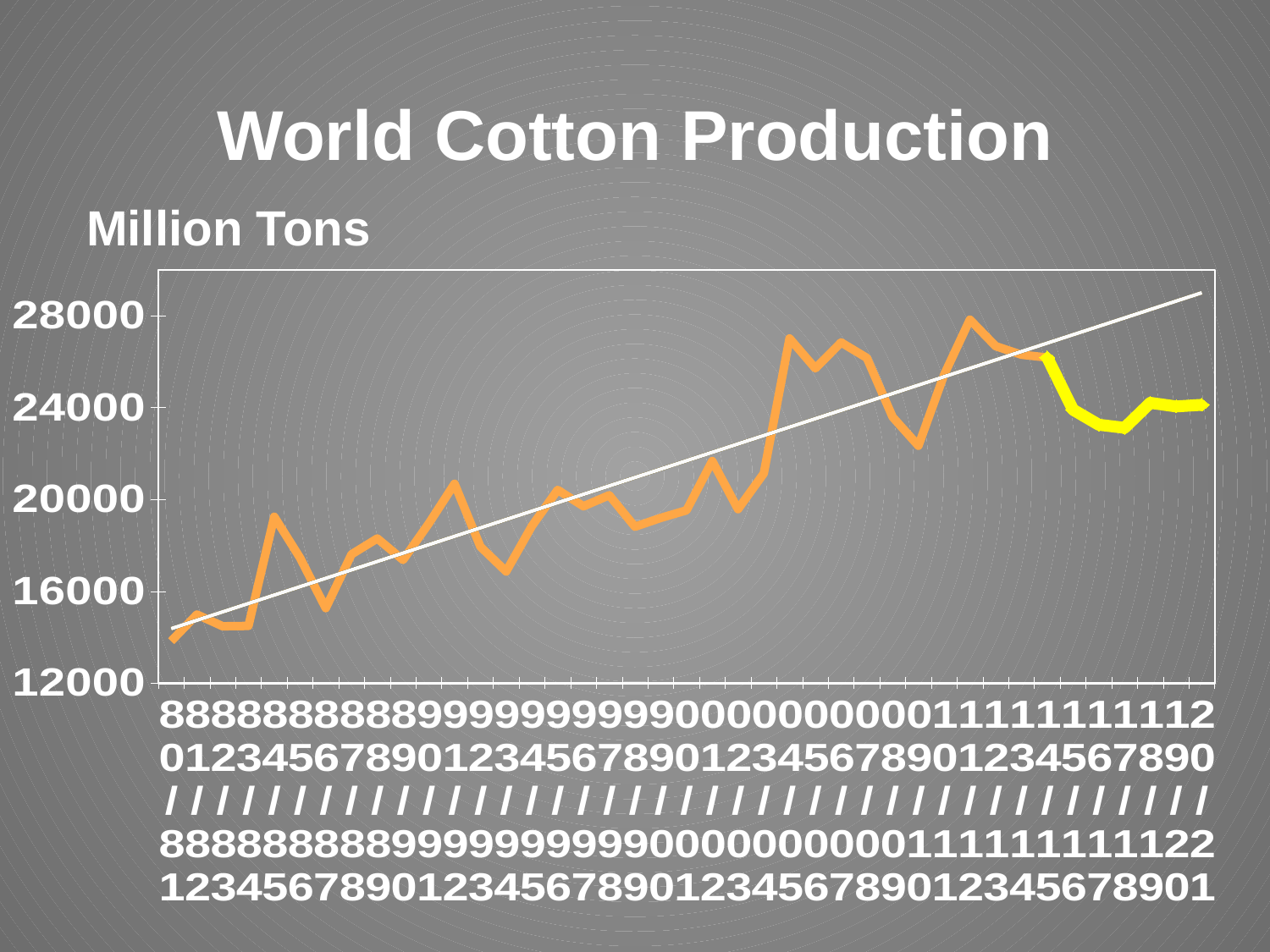
Which season has the lowest world cotton production on the chart? 80/81 How many seasons (data points) are plotted along the x axis, from 80/81 to 20/21? 41 Is the value for 11/12 greater or less than 24000? greater Is the value for 80/81 greater or less than 16000? less What kind of chart is shown on the slide? line chart What is the title of the chart? World Cotton Production Is the value for 04/05 greater or less than 24000? greater Does world cotton production generally rise or fall from 80/81 to 20/21? rise Which is larger, the value for 11/12 or the value for 80/81? 11/12 In what unit is world cotton production measured on the chart? Million Tons Which season has the highest world cotton production on the chart? 11/12